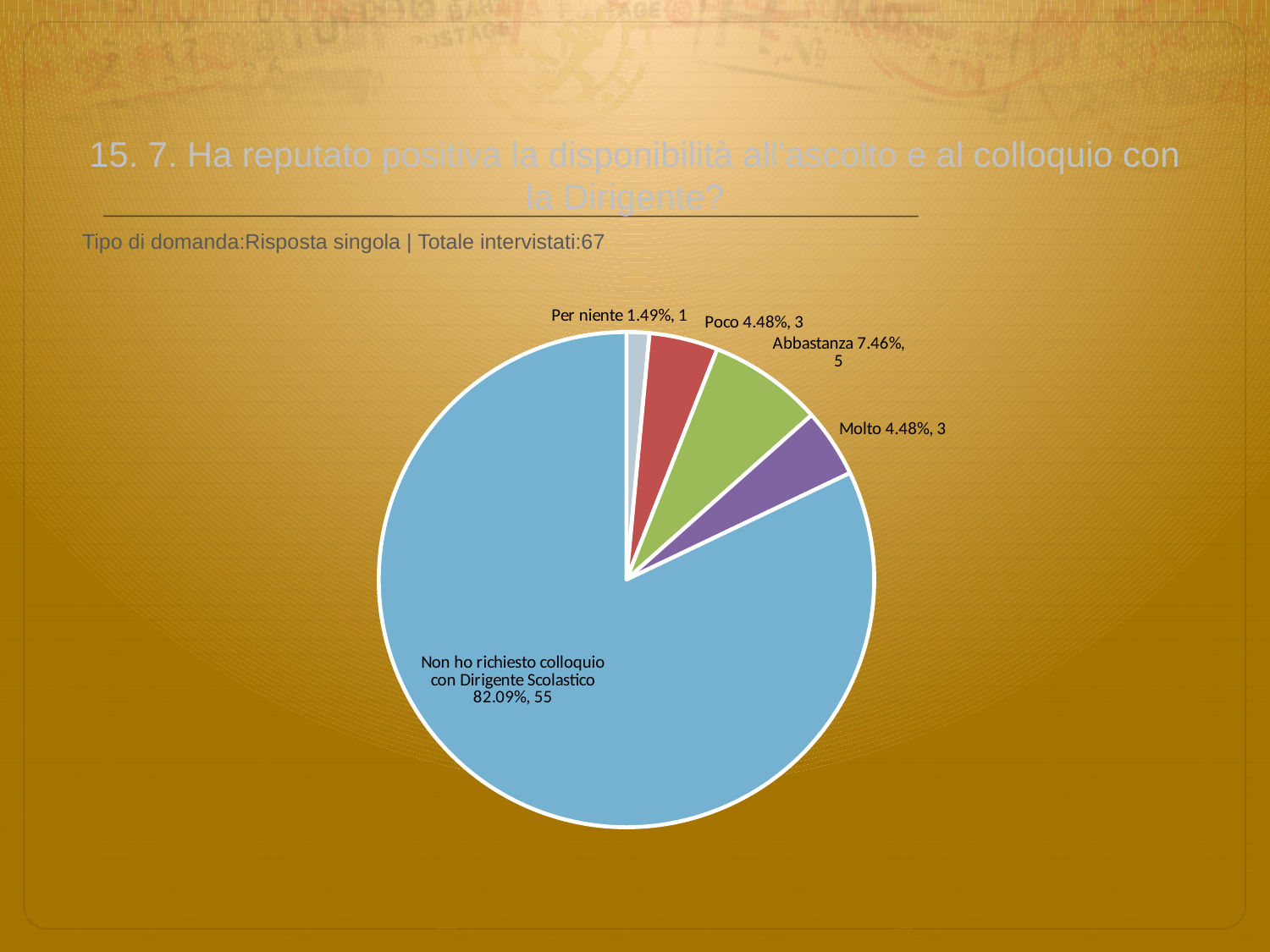
What colour is the 'Molto' slice? purple How many respondents answered 'Per niente'? 1 What percentage share does the 'Non ho richiesto colloquio con Dirigente Scolastico' slice have? 82.09% Which has more respondents, 'Poco' or 'Per niente'? Poco What kind of chart is shown on the slide? pie chart What is the difference in number of respondents between 'Abbastanza' and 'Molto'? 2 How many slices does the pie chart have? 5 What is the total number of respondents (Totale intervistati) stated on the slide? 67 How many respondents answered 'Abbastanza'? 5 Which category has the smallest slice of the pie? Per niente What percentage share does the 'Poco' slice have? 4.48% Which category has the largest slice of the pie? Non ho richiesto colloquio con Dirigente Scolastico